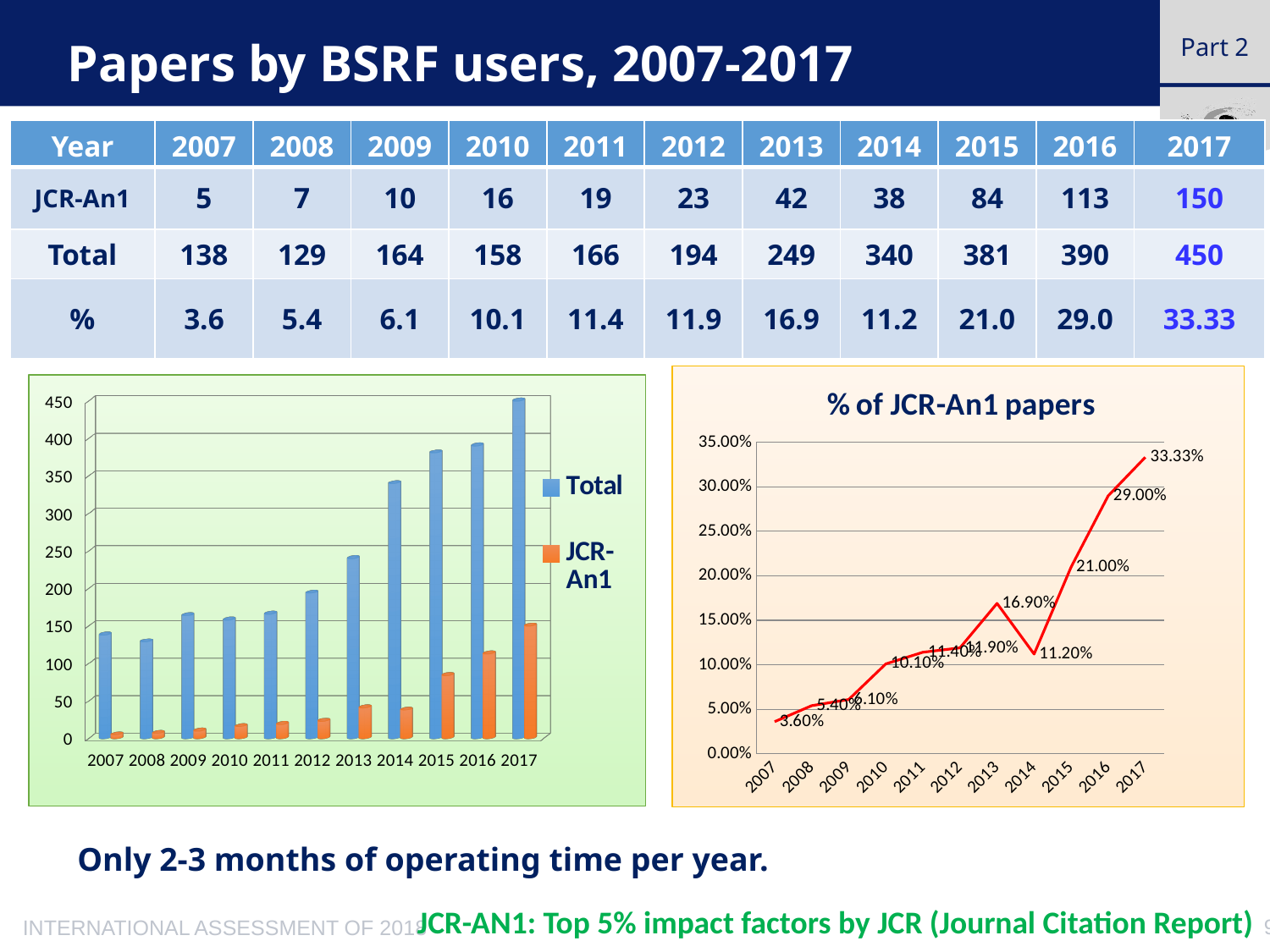
In the '% of JCR-An1 papers' chart, which year has the lowest value? 2007 In the '% of JCR-An1 papers' chart, which year has the larger value, 2013 or 2014? 2013 In the left bar chart, is the JCR-An1 value for 2015 greater or less than 100? less How many series does the legend of the left bar chart list? 2 In the '% of JCR-An1 papers' chart, which year has the highest value? 2017 In the left bar chart, is the Total value for 2017 greater or less than 400? greater What kind of chart is the '% of JCR-An1 papers' chart? line chart In the '% of JCR-An1 papers' chart, what is the value for 2017? 33.33% In the '% of JCR-An1 papers' chart, what is the difference between the 2017 and 2016 values? 4.33% In the '% of JCR-An1 papers' chart, what is the value for 2013? 16.90% What kind of chart is the chart on the left of the slide? bar chart How many years are plotted on the '% of JCR-An1 papers' chart? 11